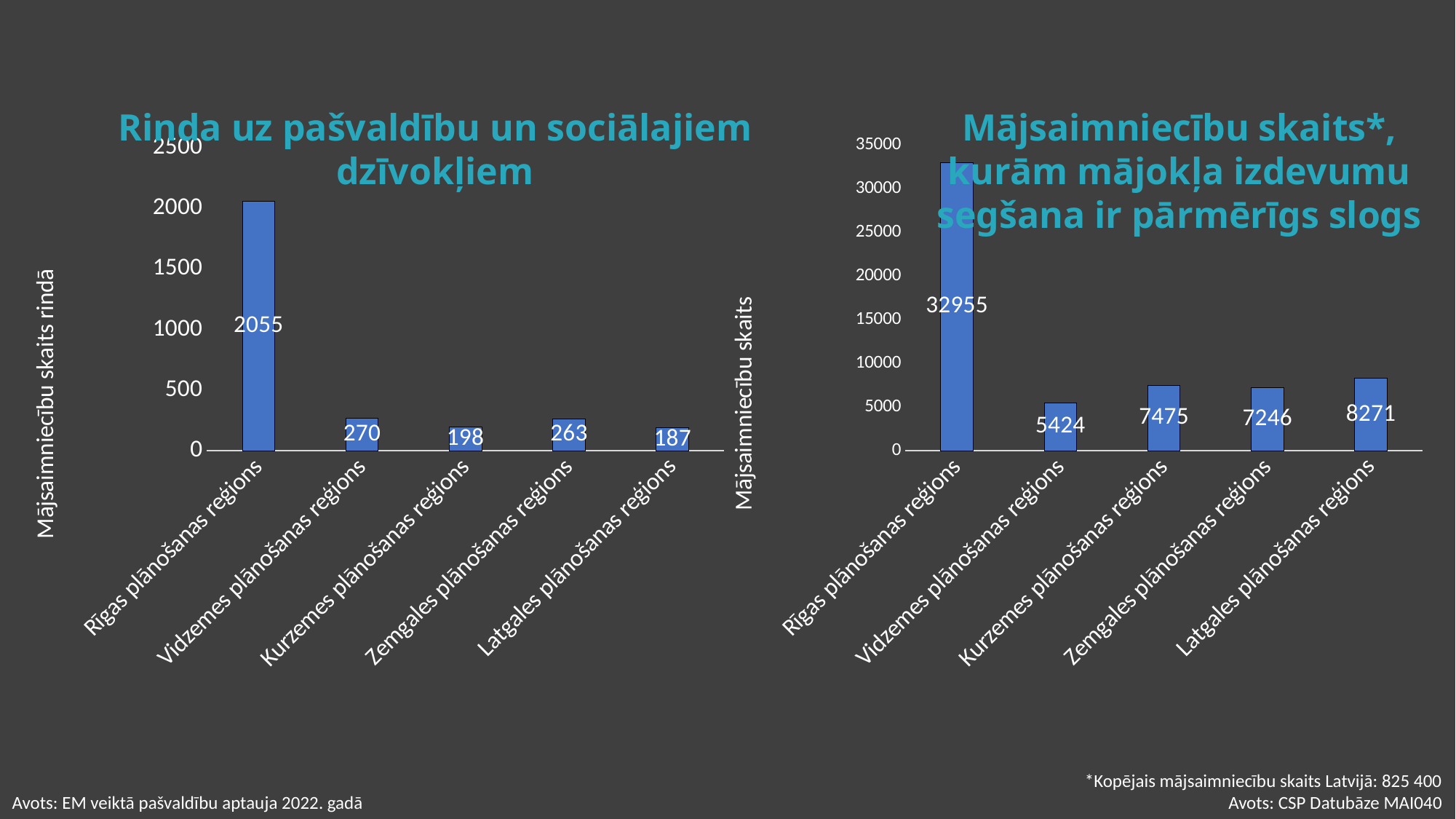
In the left chart 'Rinda uz pašvaldību un sociālajiem dzīvokļiem', which region has the lowest value? Latgales plānošanas reģions In the left chart 'Rinda uz pašvaldību un sociālajiem dzīvokļiem', what is the value for Kurzemes plānošanas reģions? 198 In the left chart 'Rinda uz pašvaldību un sociālajiem dzīvokļiem', what is the difference between Vidzemes plānošanas reģions and Zemgales plānošanas reģions? 7 In the right chart 'Mājsaimniecību skaits*, kurām mājokļa izdevumu segšana ir pārmērīgs slogs', what is the value for Latgales plānošanas reģions? 8271 In the left chart 'Rinda uz pašvaldību un sociālajiem dzīvokļiem', how many regions are shown? 5 In the left chart 'Rinda uz pašvaldību un sociālajiem dzīvokļiem', what is the value for Rīgas plānošanas reģions? 2055 What is the y-axis label of the left chart 'Rinda uz pašvaldību un sociālajiem dzīvokļiem'? Mājsaimniecību skaits rindā In the right chart 'Mājsaimniecību skaits*, kurām mājokļa izdevumu segšana ir pārmērīgs slogs', what is the value for Vidzemes plānošanas reģions? 5424 What kind of chart is the right chart 'Mājsaimniecību skaits*, kurām mājokļa izdevumu segšana ir pārmērīgs slogs'? Bar chart In the right chart 'Mājsaimniecību skaits*, kurām mājokļa izdevumu segšana ir pārmērīgs slogs', what is the difference between Rīgas plānošanas reģions and Latgales plānošanas reģions? 24684 In the right chart 'Mājsaimniecību skaits*, kurām mājokļa izdevumu segšana ir pārmērīgs slogs', which is larger: Kurzemes plānošanas reģions or Zemgales plānošanas reģions? Kurzemes plānošanas reģions In the right chart 'Mājsaimniecību skaits*, kurām mājokļa izdevumu segšana ir pārmērīgs slogs', which region has the highest value? Rīgas plānošanas reģions